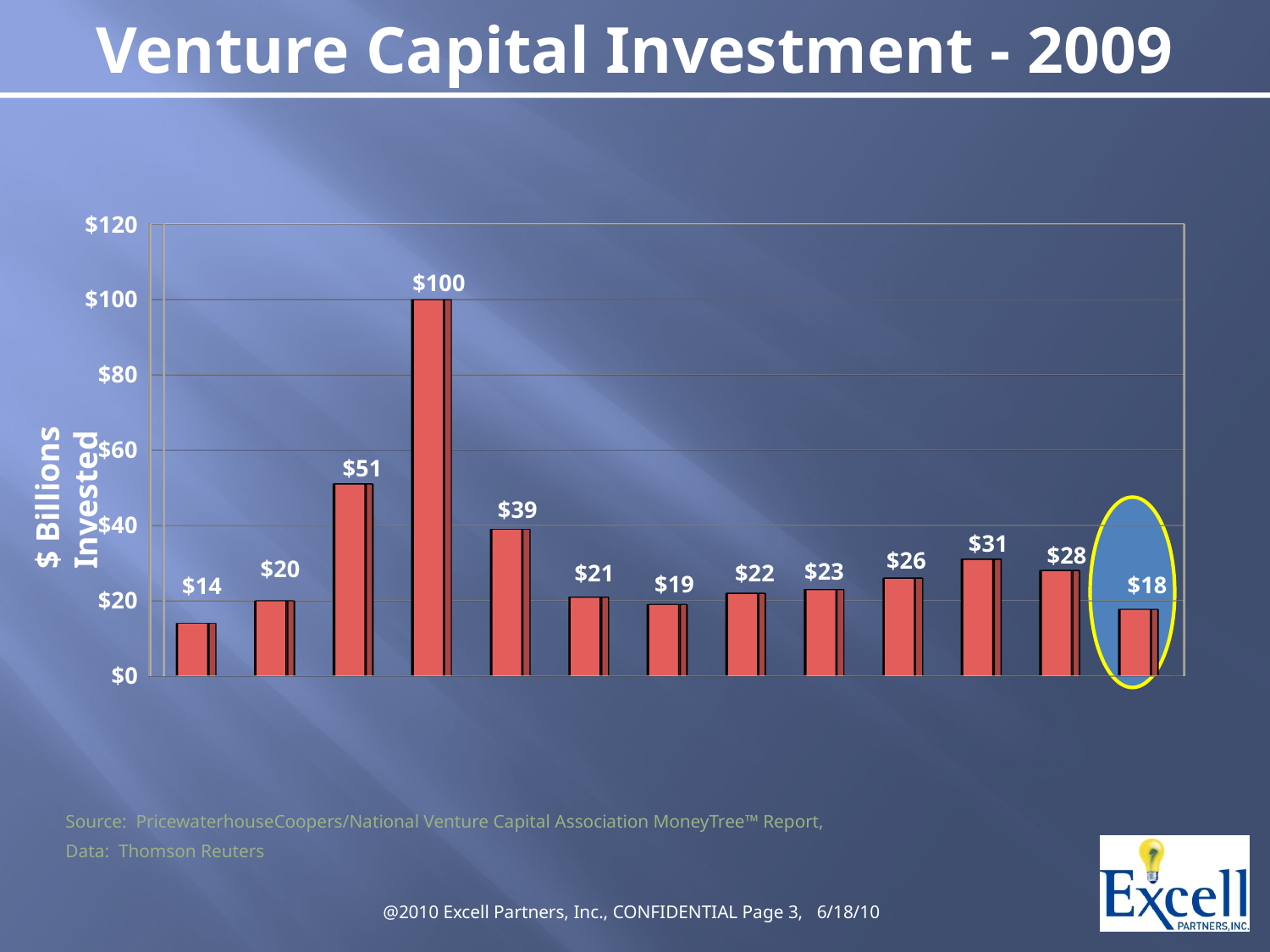
What is the lowest value shown by any bar in the chart? $14 What is the highest value shown by any bar in the chart? $100 What is the value of the first (leftmost) bar in the chart? $14 What is the label on the vertical axis of the chart? $ Billions Invested What is the difference between the tallest bar ($100) and the bar immediately to its right ($39)? $61 Is the value of the tallest bar greater or less than $80? greater What is the value of the third bar from the left in the chart? $51 What kind of chart is shown on the slide? bar chart What is the title of the slide containing the chart? Venture Capital Investment - 2009 How many bars are plotted in the chart? 13 Which is larger, the second bar from the right ($28) or the third bar from the right ($31)? the third bar from the right ($31) What is the value of the bar circled in yellow at the right end of the chart? $18